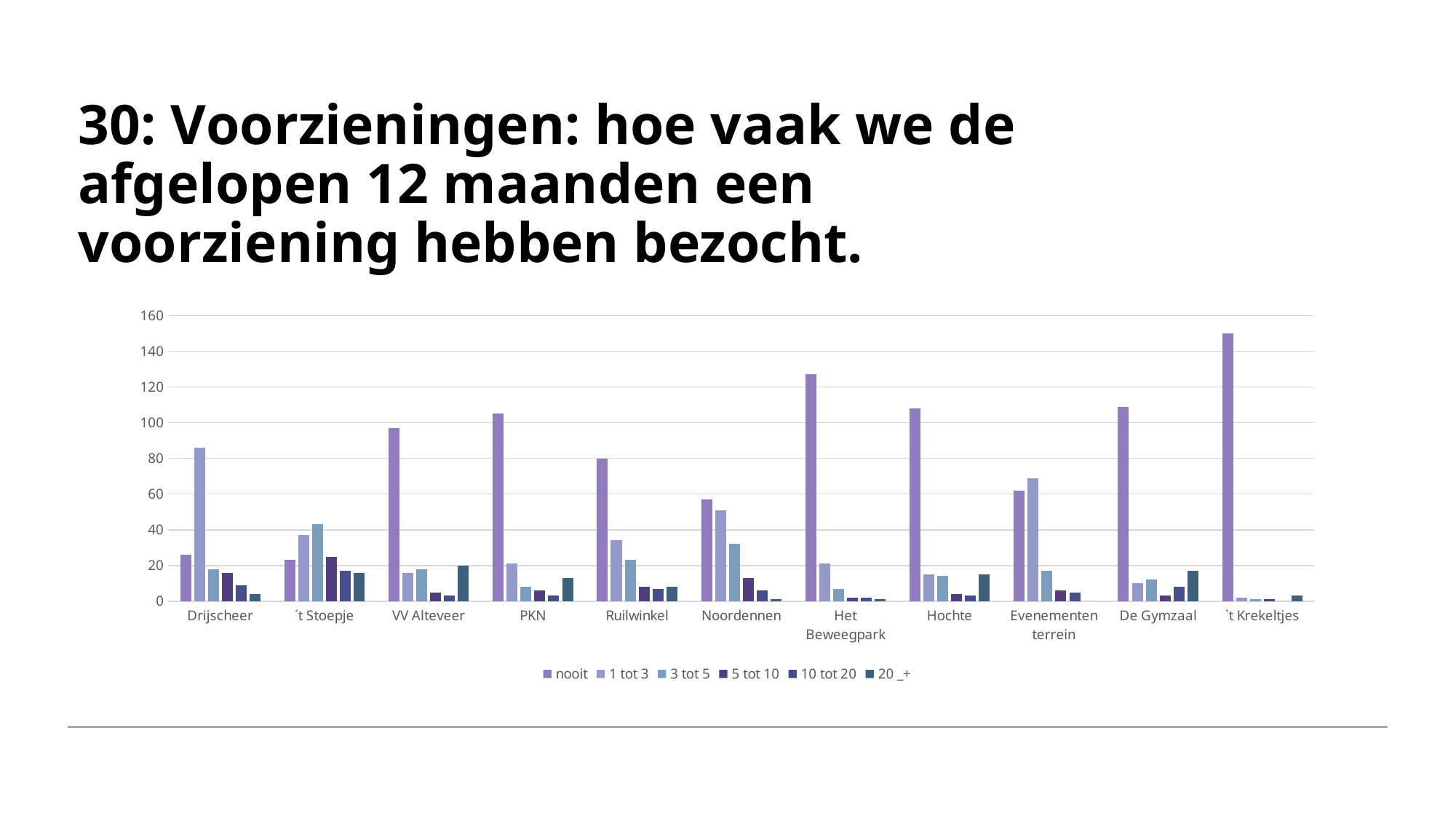
How many categories (voorzieningen) are shown along the x axis? 11 Is the '1 tot 3' value for Drijscheer greater or less than 80? greater Which is larger: the 'nooit' value for VV Alteveer or the 'nooit' value for PKN? PKN For Drijscheer, which is larger: the 'nooit' bar or the '1 tot 3' bar? 1 tot 3 Is the 'nooit' value for `t Krekeltjes greater or less than 140? greater Is the 'nooit' value for Ruilwinkel greater or less than 100? less Which category has the highest 'nooit' bar? `t Krekeltjes What is the first series listed in the legend? nooit Which category has the highest '1 tot 3' bar? Drijscheer How many series does the legend list? 6 What kind of chart is shown on the slide? bar chart